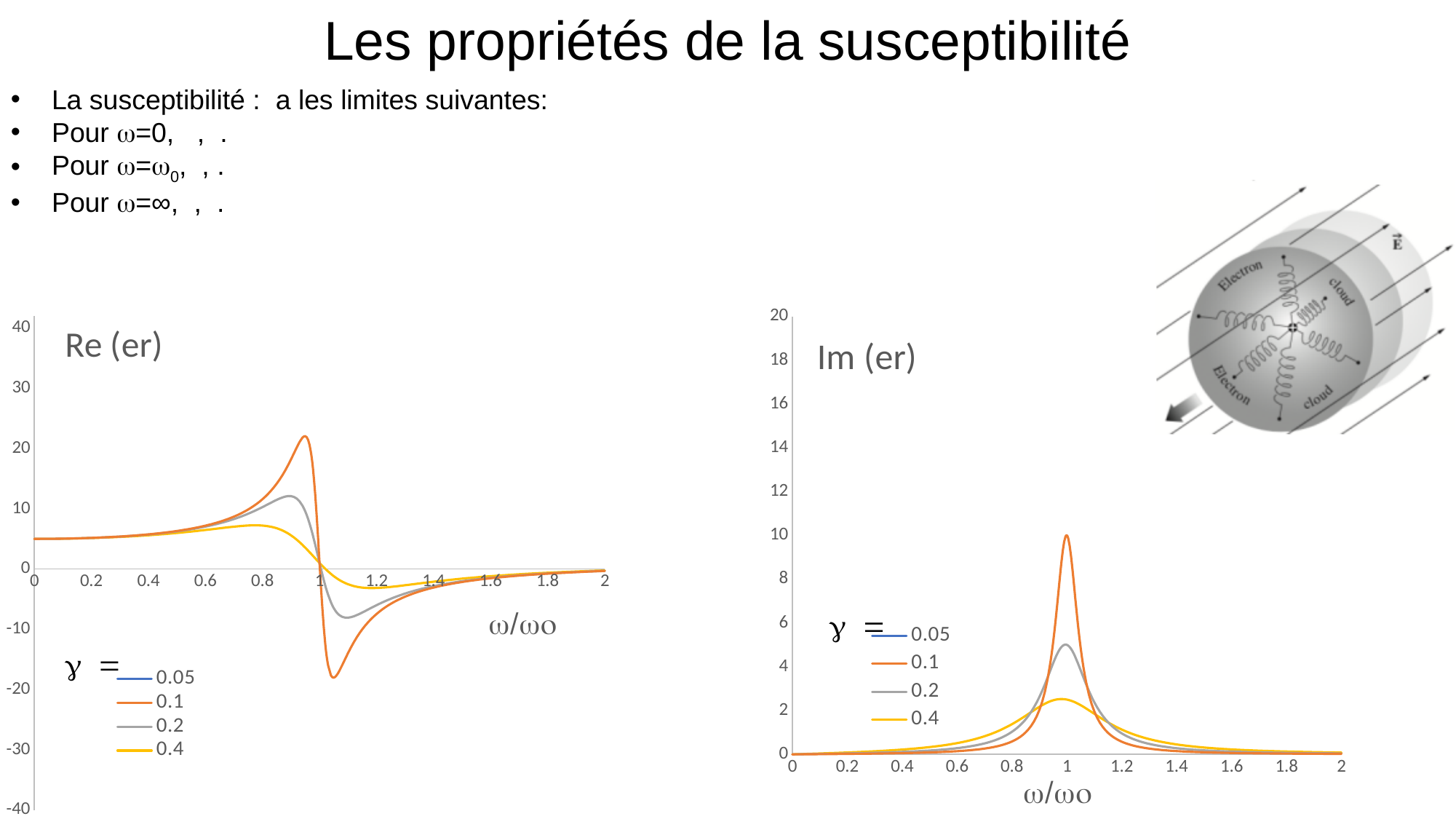
In the "Im (er)" chart, do the curves rise or fall as ω/ωo goes from 1 to 2? fall In the "Re (er)" chart, is the maximum value of the γ = 0.1 curve greater or less than 10? greater In the "Im (er)" chart, which γ value has the highest peak? 0.1 In the "Re (er)" chart, is the minimum value of the γ = 0.1 curve greater or less than -10? less What label is shown on the x axis of the "Im (er)" chart? ω/ωo What kind of chart is the "Re (er)" chart on the left? line chart In the "Im (er)" chart, which curve reaches a higher peak, γ = 0.2 or γ = 0.4? γ = 0.2 In the "Im (er)" chart, is the peak value of the γ = 0.4 curve greater or less than 4? less How many series does the legend of the "Im (er)" chart list? 4 What are the γ values listed in the legend of the "Re (er)" chart? 0.05, 0.1, 0.2, 0.4